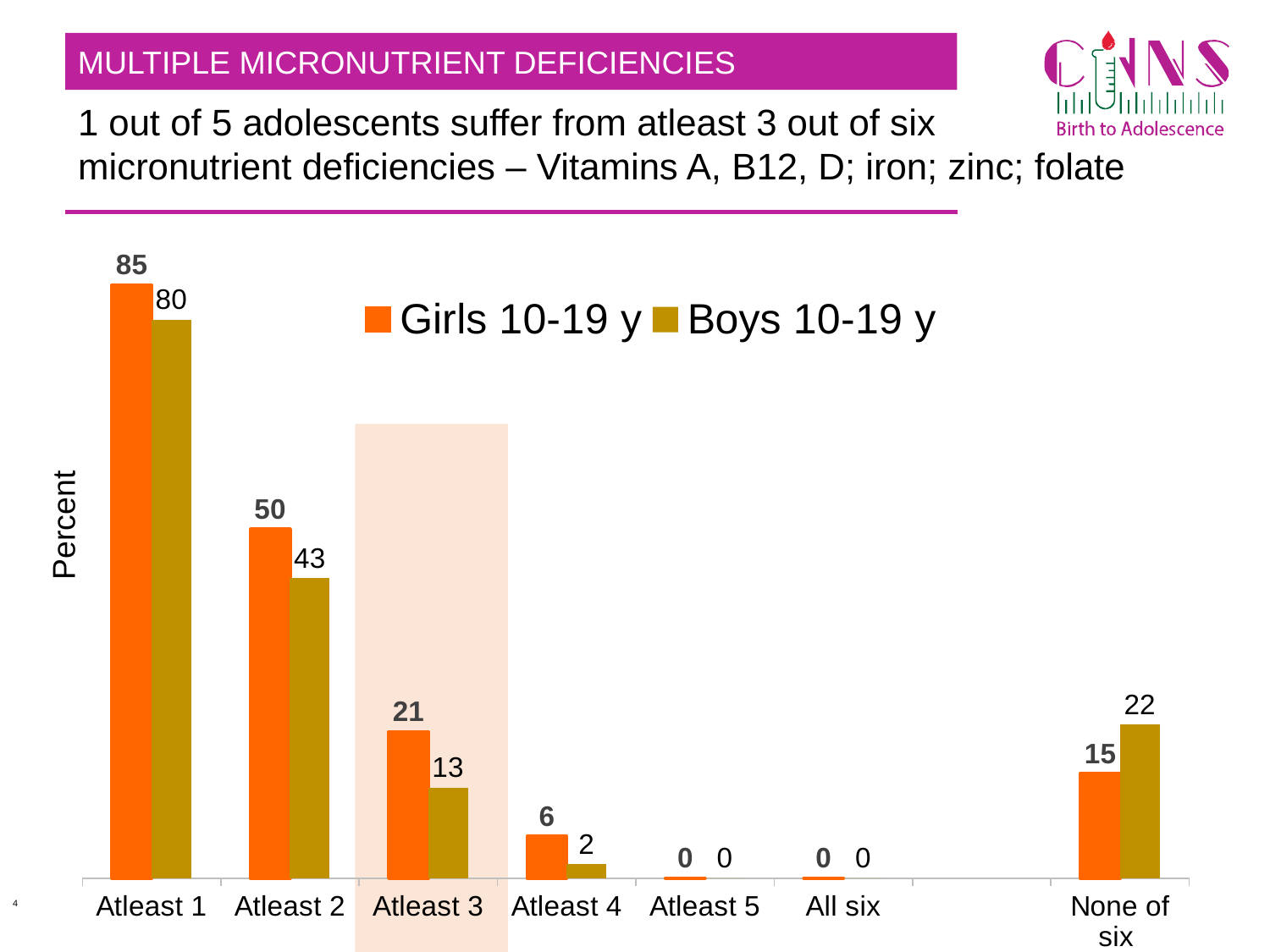
Which category has the highest value for Boys 10-19 y? Atleast 1 What kind of chart is shown on the slide? Bar chart What is the value for Girls 10-19 y in the Atleast 3 category? 21 What is the difference between Girls 10-19 y and Boys 10-19 y in the Atleast 1 category? 5 In the None of six category, which series has the larger value, Girls 10-19 y or Boys 10-19 y? Boys 10-19 y How many categories are shown on the x axis? 7 What is the value for Boys 10-19 y in the None of six category? 22 What is the value for Boys 10-19 y in the Atleast 2 category? 43 In the Atleast 4 category, which series has the larger value, Girls 10-19 y or Boys 10-19 y? Girls 10-19 y How many series does the legend list? 2 What is the difference between Girls 10-19 y and Boys 10-19 y in the Atleast 3 category? 8 What is the value for Girls 10-19 y in the Atleast 1 category? 85